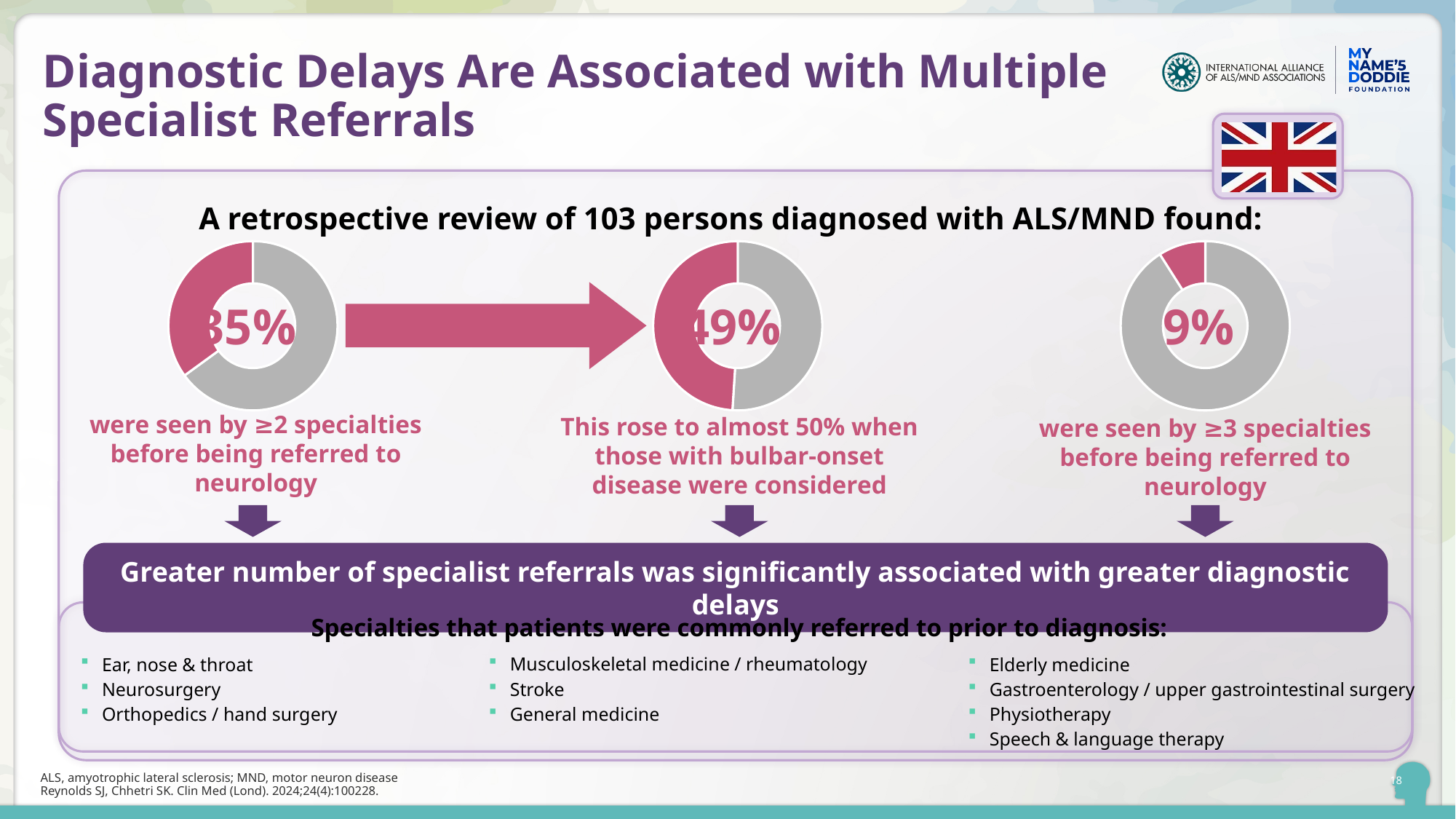
Is the highlighted share in the leftmost donut chart larger or smaller than the highlighted share in the rightmost donut chart? Larger In the rightmost donut chart, what percentage of patients were seen by ≥3 specialties before being referred to neurology? 9% What colour is used for the highlighted segment in each donut chart? Pink/red What kind of chart is used to show the percentages on this slide? Donut (pie) chart Which of the three donut charts shows the lowest percentage? The rightmost chart (9%) In the middle donut chart, what percentage is shown when those with bulbar-onset disease were considered? 49% How many donut charts are shown on the slide? 3 Is the highlighted share in the middle donut chart larger or smaller than the highlighted share in the leftmost donut chart? Larger Which of the three donut charts shows the highest percentage? The middle chart (49%) What is the difference between the percentage in the middle donut chart and the percentage in the rightmost donut chart? 40 percentage points What is the title of the slide containing the donut charts? Diagnostic Delays Are Associated with Multiple Specialist Referrals